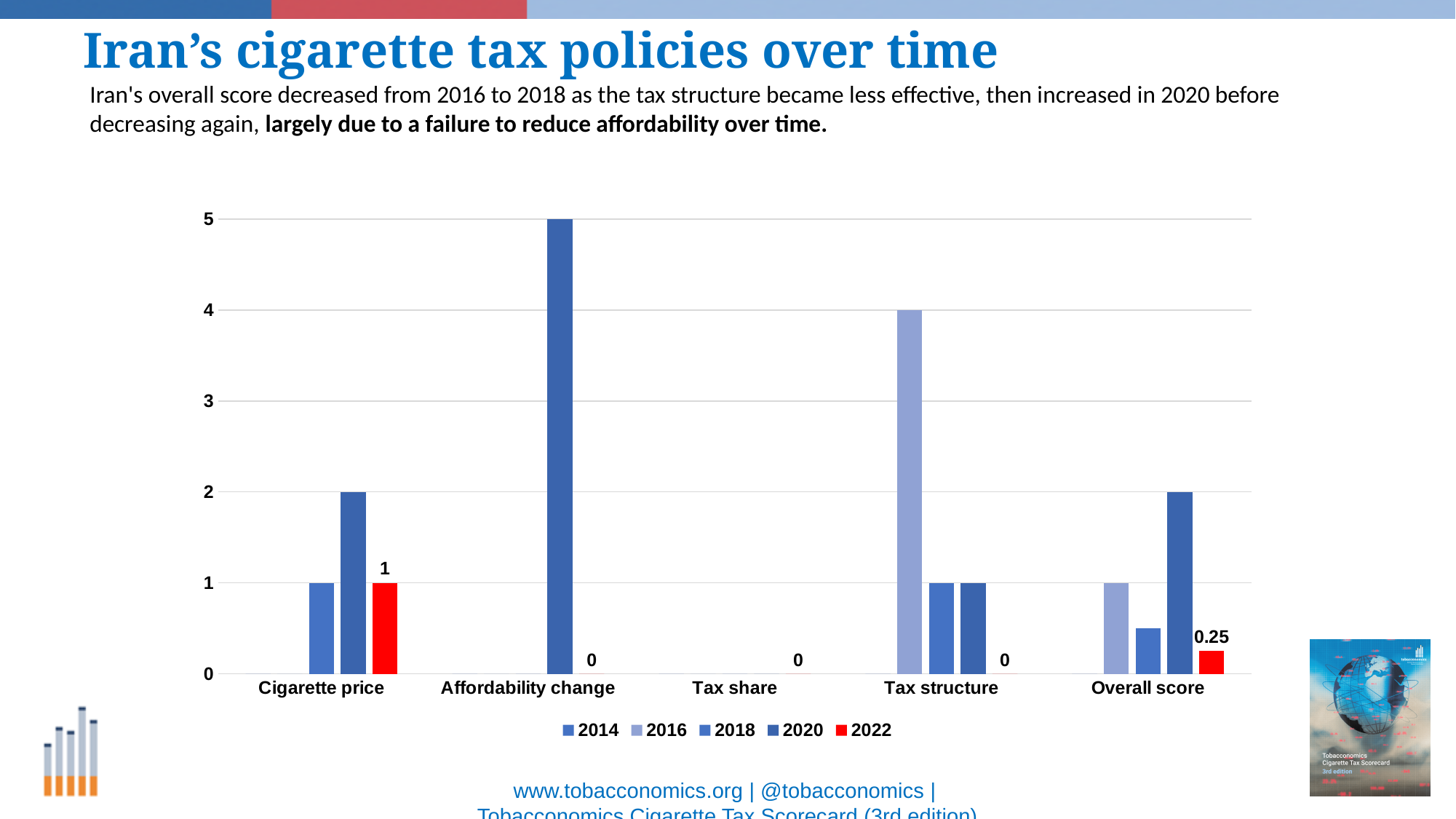
Is the 2016 value for Tax structure greater or less than 3? greater How many series does the legend list? 5 What is the 2022 value for Tax structure? 0 How many categories are shown on the x axis? 5 What is the 2016 value for Tax structure? 4 What colour represents the 2022 series in the legend? red Which is larger for Overall score, the 2016 value or the 2022 value? 2016 What is the 2022 value for Cigarette price? 1 What type of chart is shown on the slide? bar chart What is the difference between the 2016 and 2022 values for Tax structure? 4 Which category contains the tallest bar in the chart? Affordability change What is the 2022 value for Overall score? 0.25